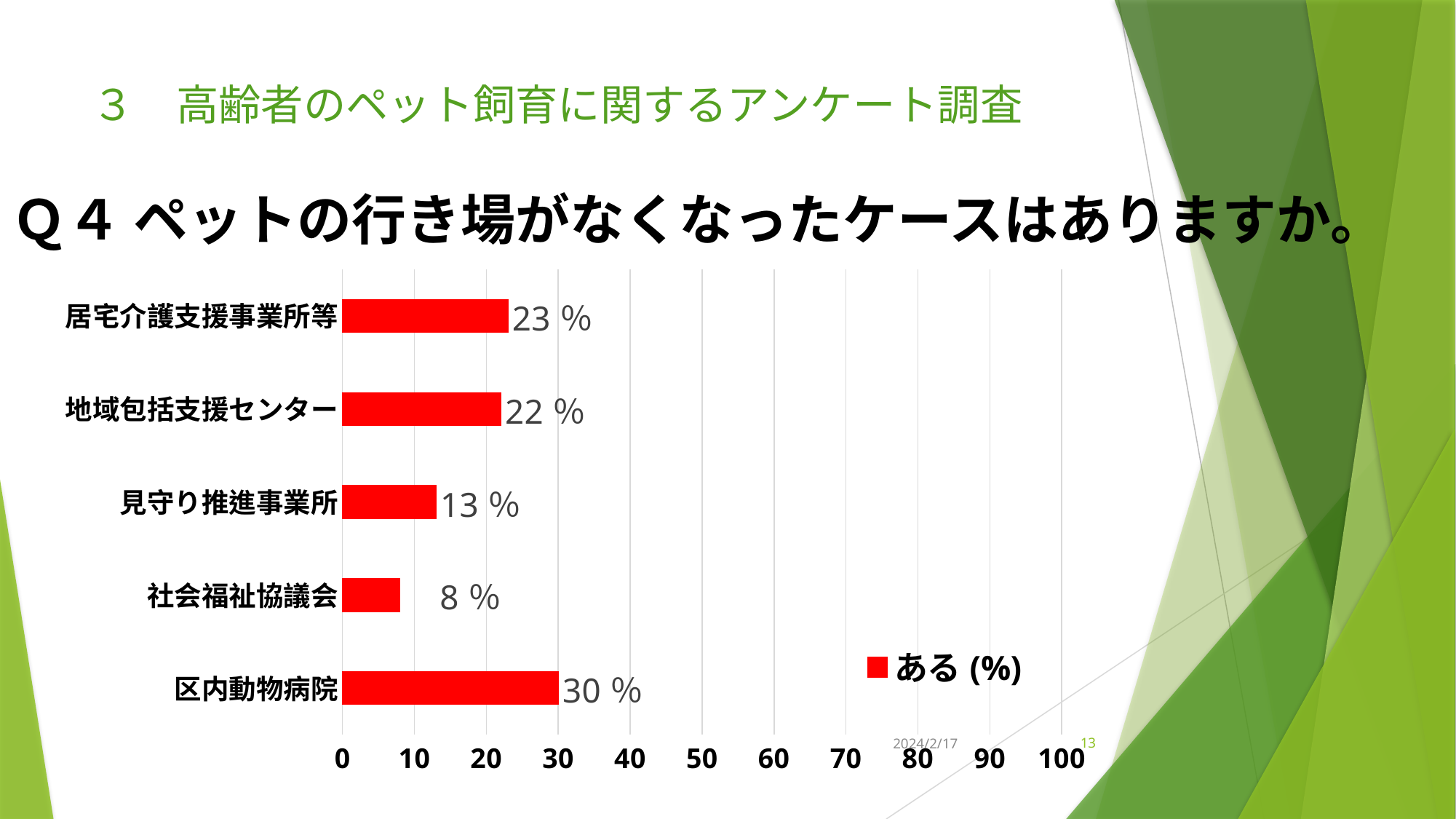
Is the value for 区内動物病院 greater or less than 20? greater Which is larger, the value for 地域包括支援センター or the value for 見守り推進事業所? 地域包括支援センター Which category has the highest value? 区内動物病院 What is the value for 区内動物病院? 30 % What is the value for 見守り推進事業所? 13 % What kind of chart is shown on the slide? bar chart What is the legend entry shown in the chart? ある (%) What is the value for 居宅介護支援事業所等? 23 % What is the value for 社会福祉協議会? 8 % How many categories are shown in the chart? 5 Which category has the lowest value? 社会福祉協議会 What is the difference between the values for 区内動物病院 and 社会福祉協議会? 22 %